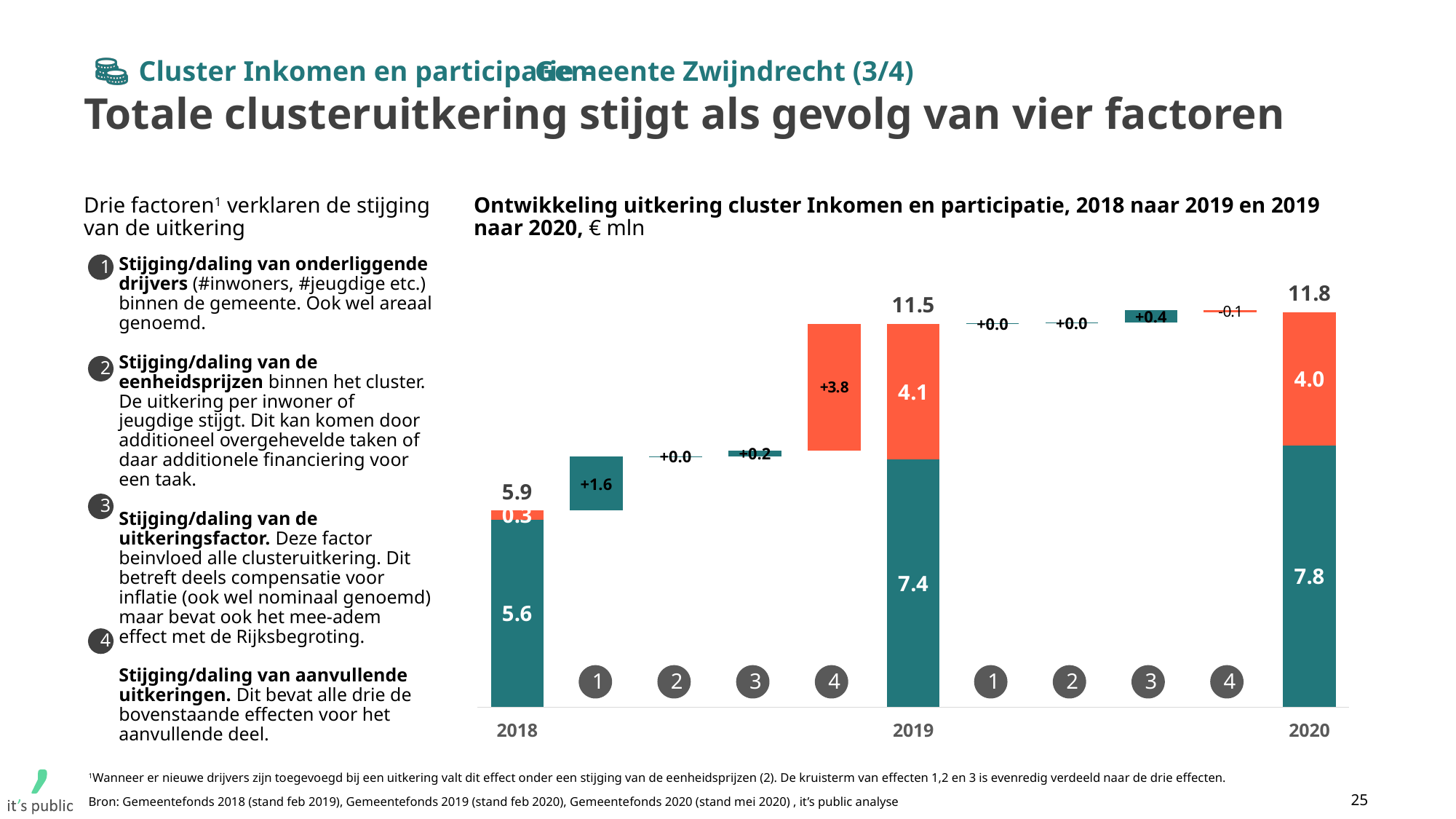
Which year has the highest total cluster payout? 2020 Do the total cluster payouts rise or fall from 2018 to 2020? Rise What is the value of the teal (lower) segment of the 2019 bar? 7.4 What is the value of step 3 between 2019 and 2020? +0.4 What is the total cluster payout shown for 2018? 5.9 Which is larger: step 1 between 2018 and 2019 (+1.6) or step 4 between 2018 and 2019 (+3.8)? Step 4 (+3.8) What is the difference between the 2019 total (11.5) and the 2018 total (5.9)? 5.6 What is the value of the orange (upper) segment of the 2020 bar? 4.0 What is the total cluster payout shown for 2019? 11.5 What is the total cluster payout shown for 2020? 11.8 What is the value of step 4 between 2018 and 2019? +3.8 Which year has the lowest total cluster payout? 2018